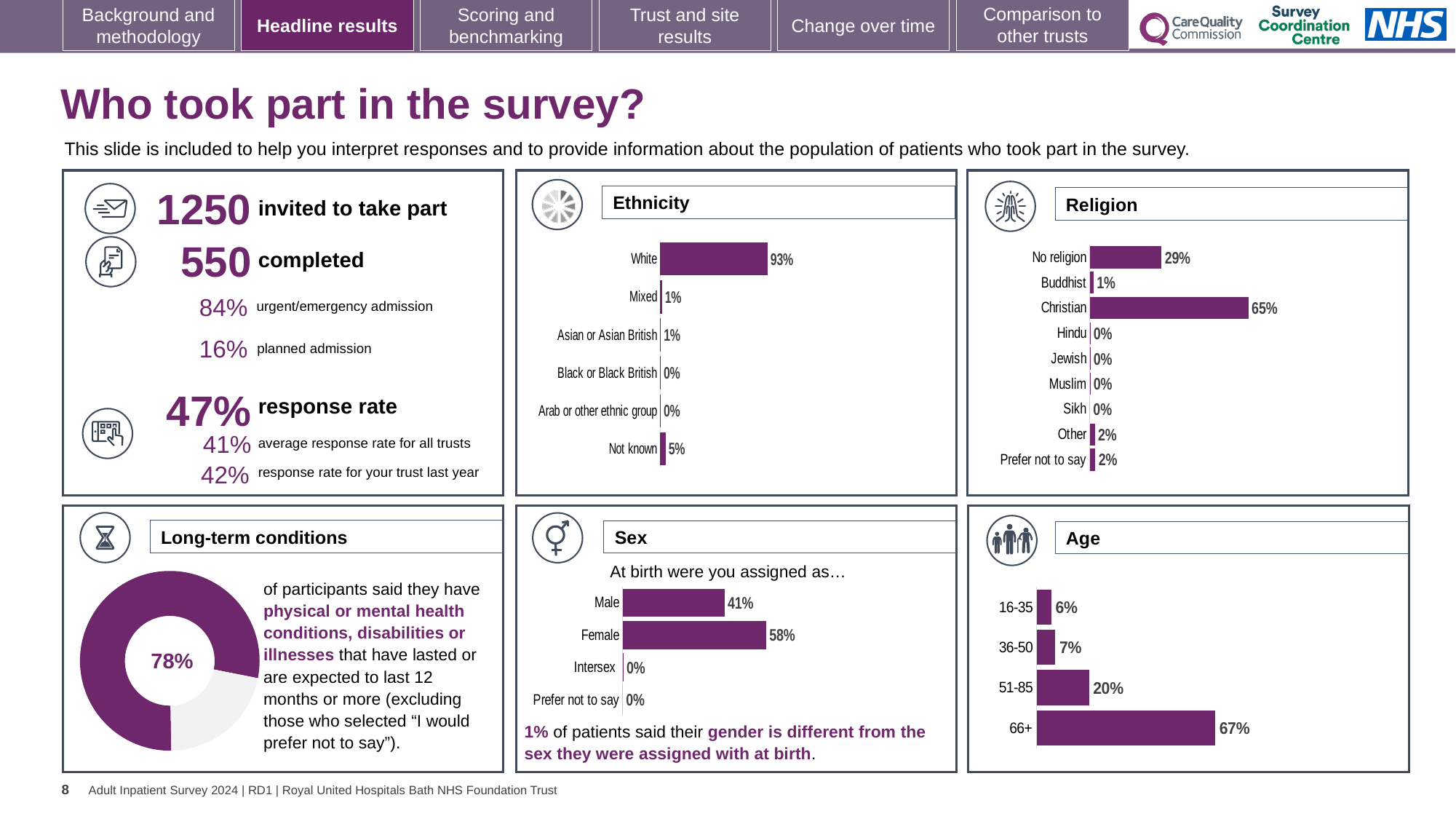
In the Sex chart, what is the difference between Female and Male? 17% In the Religion chart, what is the difference between Christian and No religion? 36% In the Ethnicity chart, which category has the highest value? White In the Religion chart, what is the value for Christian? 65% What kind of chart is the Long-term conditions chart? doughnut chart In the Ethnicity chart, what is the value for White? 93% In the Religion chart, how many categories are shown? 9 In the Age chart, do the values rise or fall from 16-35 to 66+? rise In the Age chart, which age group has the lowest value? 16-35 In the Ethnicity chart, what is the value for Not known? 5% In the Sex chart, which is larger, Male or Female? Female In the Age chart, what is the value for 66+? 67%